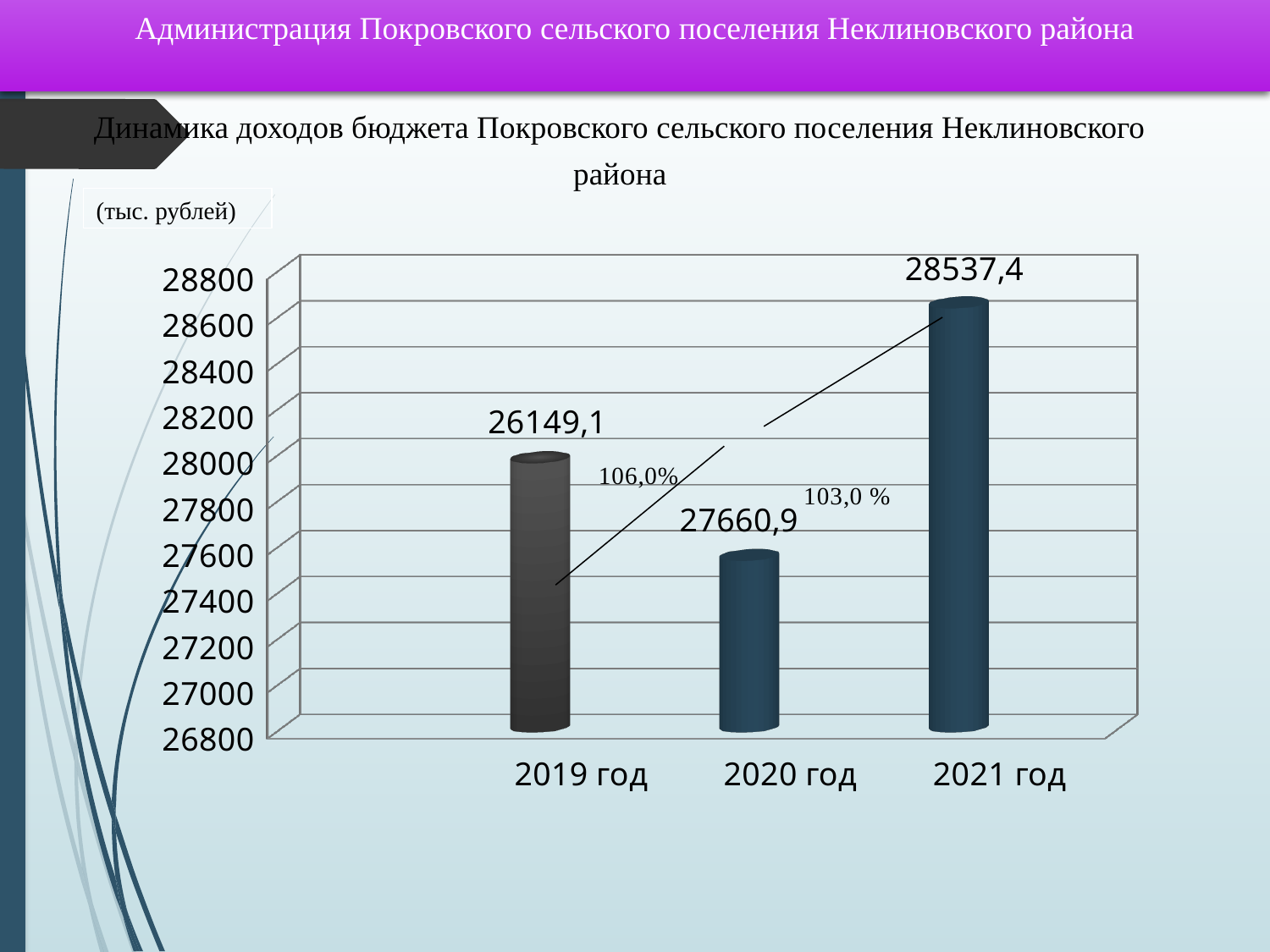
How many years are shown on the chart? 3 What is the difference between the values for 2021 год and 2020 год? 876,5 What percentage is written next to the arrow between the 2020 год and 2021 год bars? 103,0 % What is the value for 2019 год? 26149,1 Which is larger, the value for 2021 год or the value for 2020 год? 2021 год What kind of chart is shown on the slide? bar chart In what units are the values on the chart given? тыс. рублей What is the value for 2021 год? 28537,4 Which year has the highest value? 2021 год What is the value for 2020 год? 27660,9 Is the value for 2021 год greater or less than 28400? greater What is the difference between the values for 2021 год and 2019 год? 2388,3